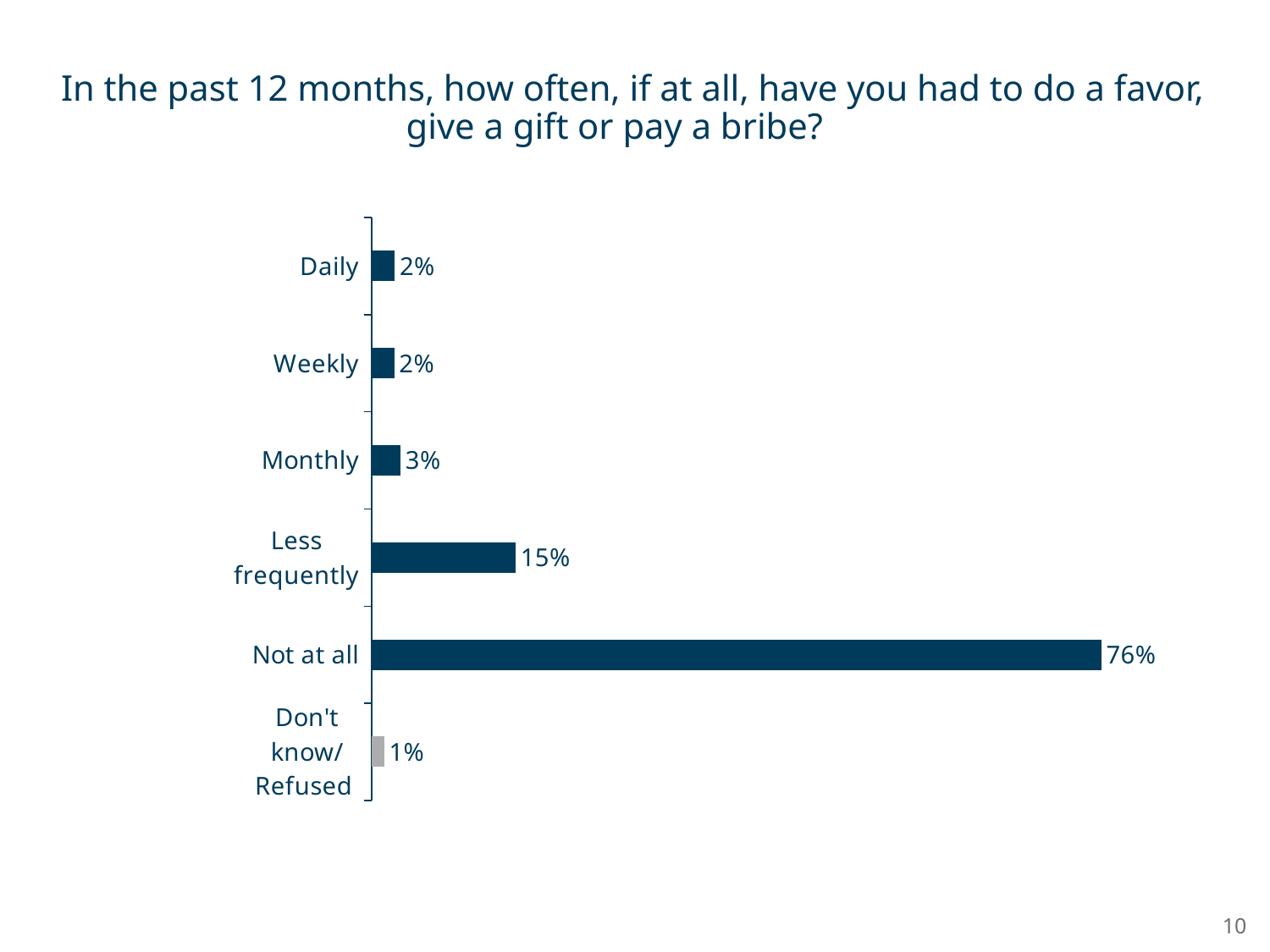
What kind of chart is shown on the slide? Bar chart What percentage answered "Monthly"? 3% What is the difference between the values for "Not at all" and "Less frequently"? 61% What is the value for "Less frequently"? 15% What is the value for "Don't know/ Refused"? 1% What percentage of respondents answered "Not at all"? 76% Which category has the lowest value? Don't know/ Refused Which category has the highest value? Not at all Which bar is shown in grey rather than dark blue? Don't know/ Refused How many categories are shown in the chart? 6 Which is larger, the value for "Less frequently" or the value for "Monthly"? Less frequently What is the difference between the values for "Monthly" and "Daily"? 1%